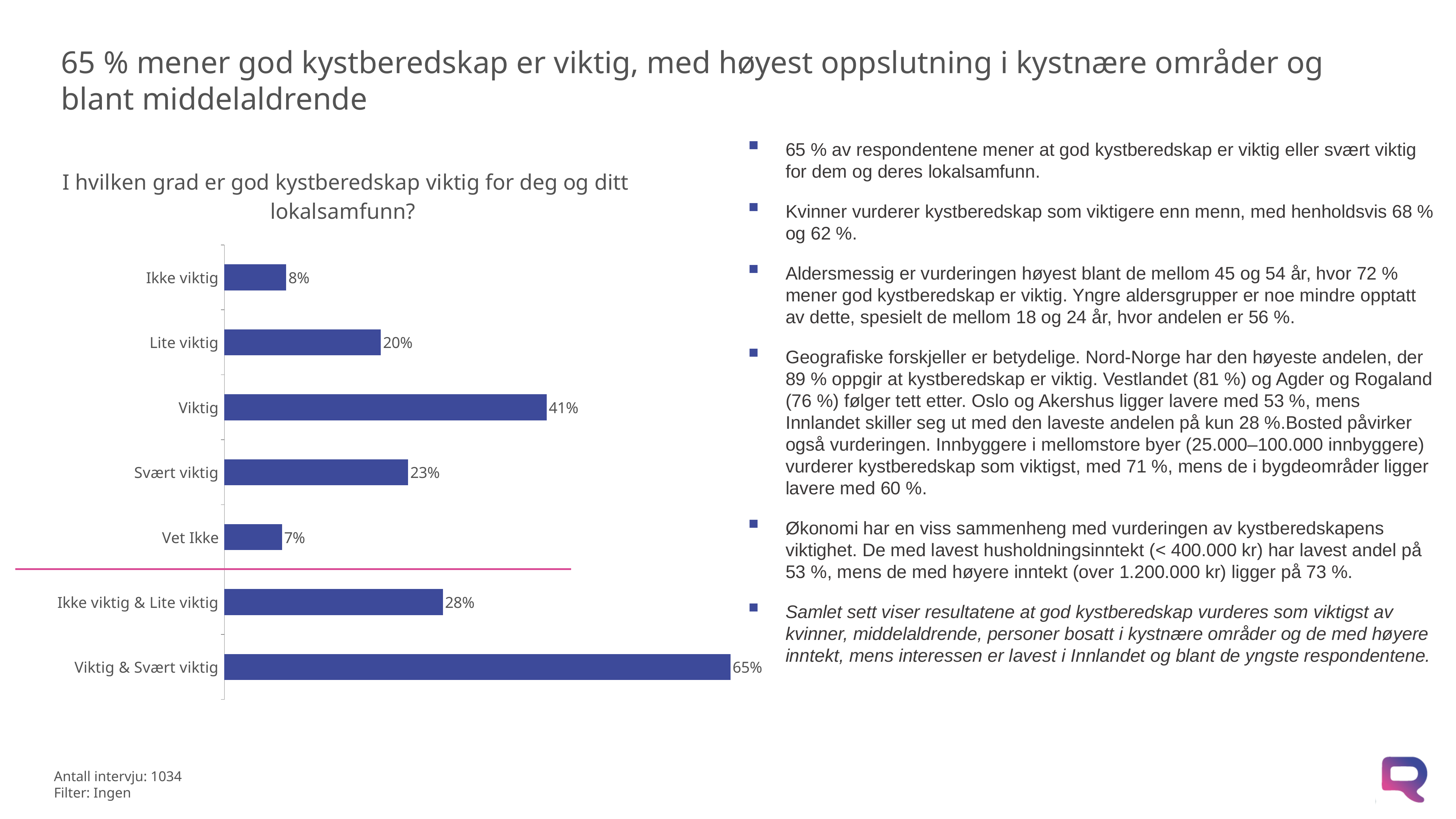
What is the value for "Ikke viktig & Lite viktig"? 28% What is the value for "Viktig"? 41% What is the difference between the values for "Viktig" and "Svært viktig"? 18% What kind of chart is shown on the slide? Bar chart What is the difference between the values for "Lite viktig" and "Ikke viktig"? 12% Which category has the lowest value? Vet Ikke What is the title of the chart? I hvilken grad er god kystberedskap viktig for deg og ditt lokalsamfunn? Which is larger, the value for "Lite viktig" or the value for "Svært viktig"? Svært viktig How many categories are shown in the chart? 7 What is the value for "Svært viktig"? 23% What is the value for "Vet Ikke"? 7% Which category has the highest value? Viktig & Svært viktig